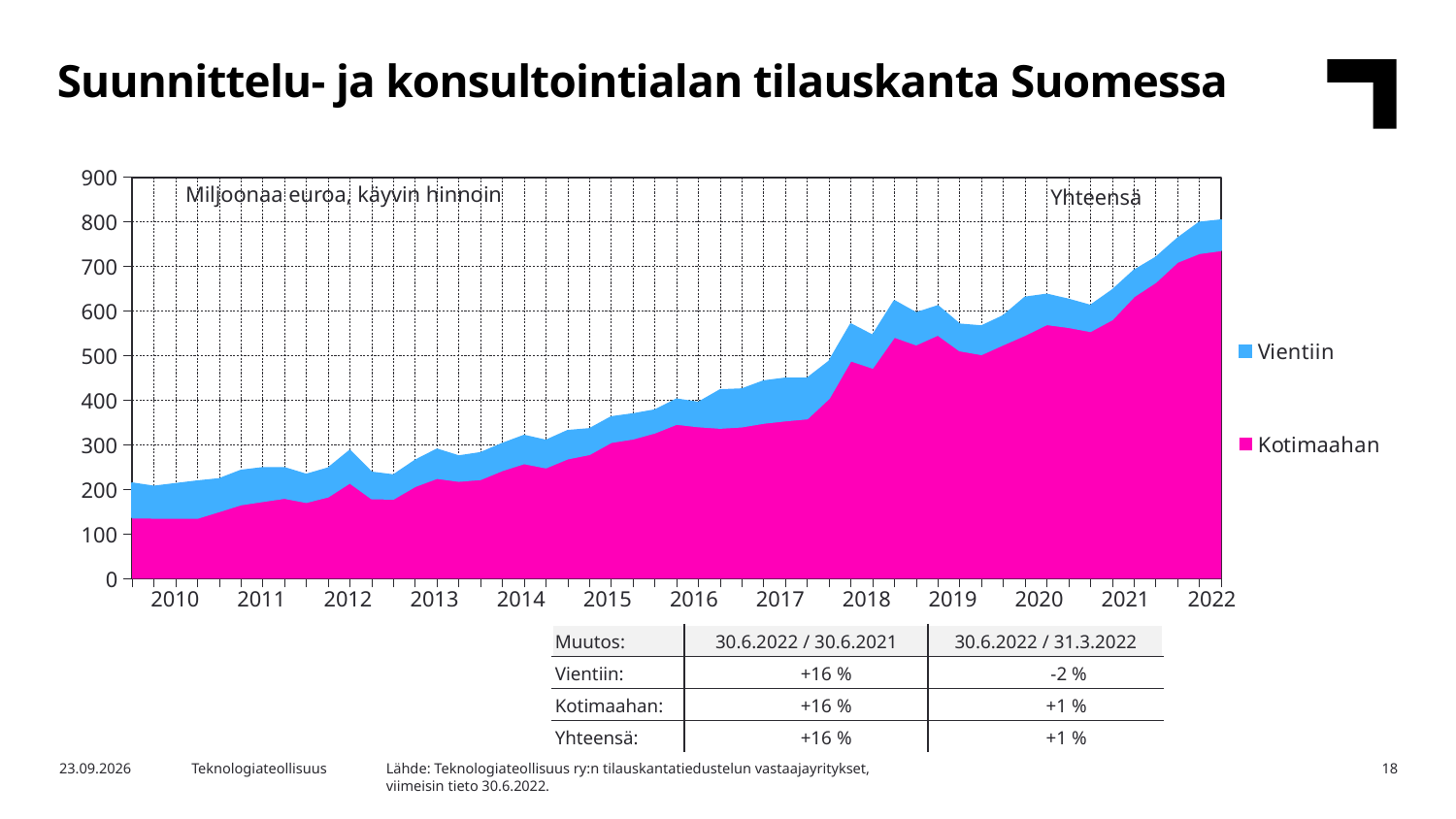
What unit is stated in the label at the top left of the chart? Miljoonaa euroa, käyvin hinnoin Which two series are listed in the chart legend? Vientiin and Kotimaahan What kind of chart is shown on the slide? Stacked area chart Does the total order backlog (Yhteensä) generally rise or fall from 2010 to 2022? Rise In which year is the total order backlog at its lowest level? 2010 In which year does the total order backlog reach its highest level? 2022 How many series does the chart legend list? 2 Is the total value (Yhteensä) at the start of 2010 greater or less than 300? less Is the Kotimaahan value at the start of 2010 greater or less than 200? less Is the Kotimaahan value in 2022 greater or less than 600? greater In 2022, which series is larger, Vientiin or Kotimaahan? Kotimaahan